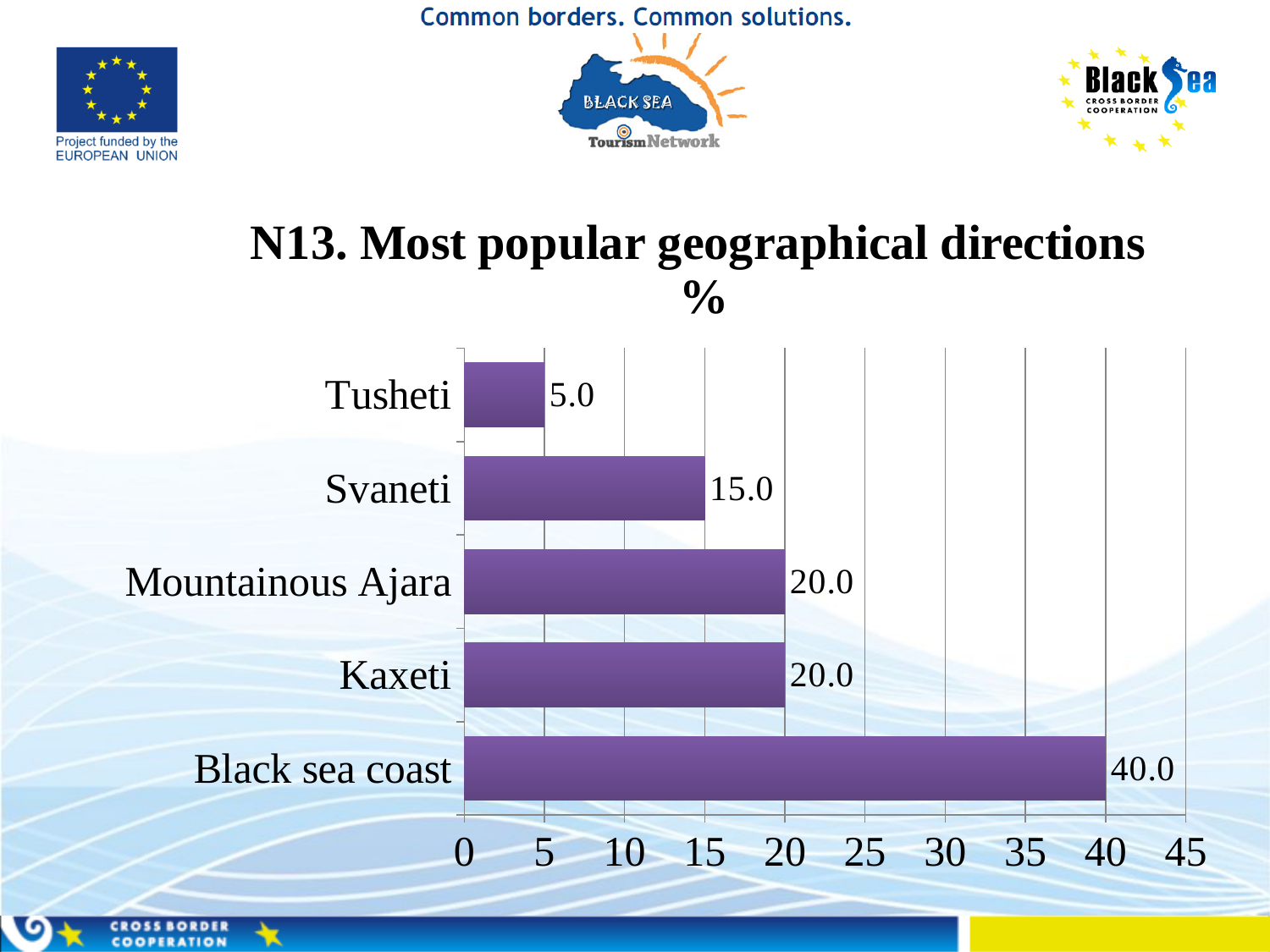
How many categories are shown in the chart? 5 Which category has the lowest value? Tusheti What is the value for Svaneti? 15.0 What is the title of the chart? N13. Most popular geographical directions % What kind of chart is shown on the slide? Bar chart What is the difference between the values for Svaneti and Tusheti? 10.0 Which is larger, the value for Svaneti or the value for Kaxeti? Kaxeti Which category has the highest value? Black sea coast What is the difference between the values for Black sea coast and Kaxeti? 20.0 What is the value for Tusheti? 5.0 What is the value for Mountainous Ajara? 20.0 What is the value for Black sea coast? 40.0